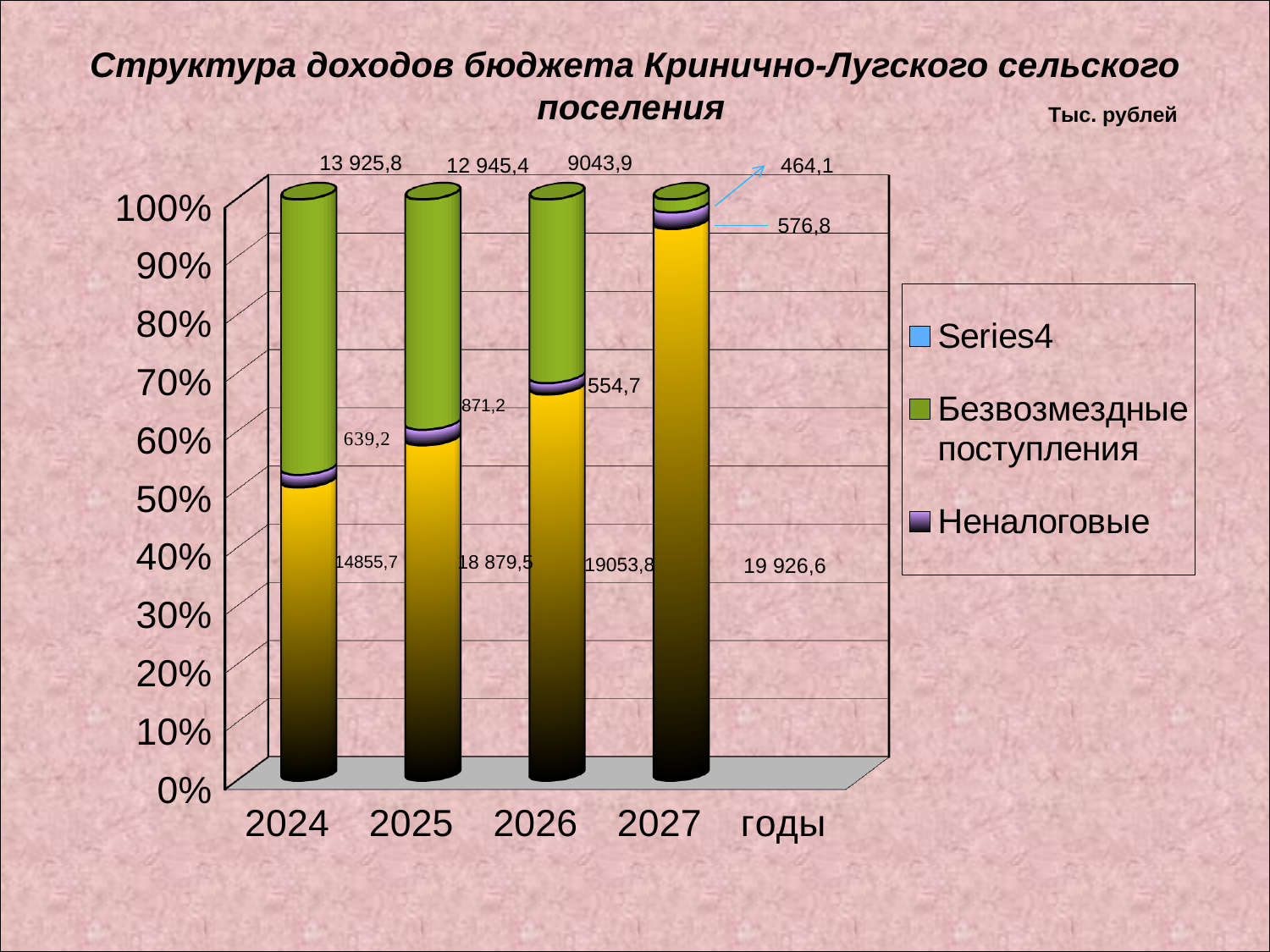
What is the difference between Безвозмездные поступления in 2024 and 2025? 980,4 What value is labelled on the bottom yellow segment of the 2027 bar? 19 926,6 What is the value of Неналоговые for 2025? 871,2 What is the value of Неналоговые for 2026? 554,7 What is the value of Безвозмездные поступления for 2024? 13 925,8 What is the value of Безвозмездные поступления for 2027? 464,1 In which year is Безвозмездные поступления the lowest? 2027 Does Безвозмездные поступления rise or fall from 2024 to 2027? fall How many series does the legend list? 3 How many years are shown on the x axis? 4 Which is larger: Неналоговые in 2024 or in 2027? 2024 In which year is Неналоговые the highest? 2025